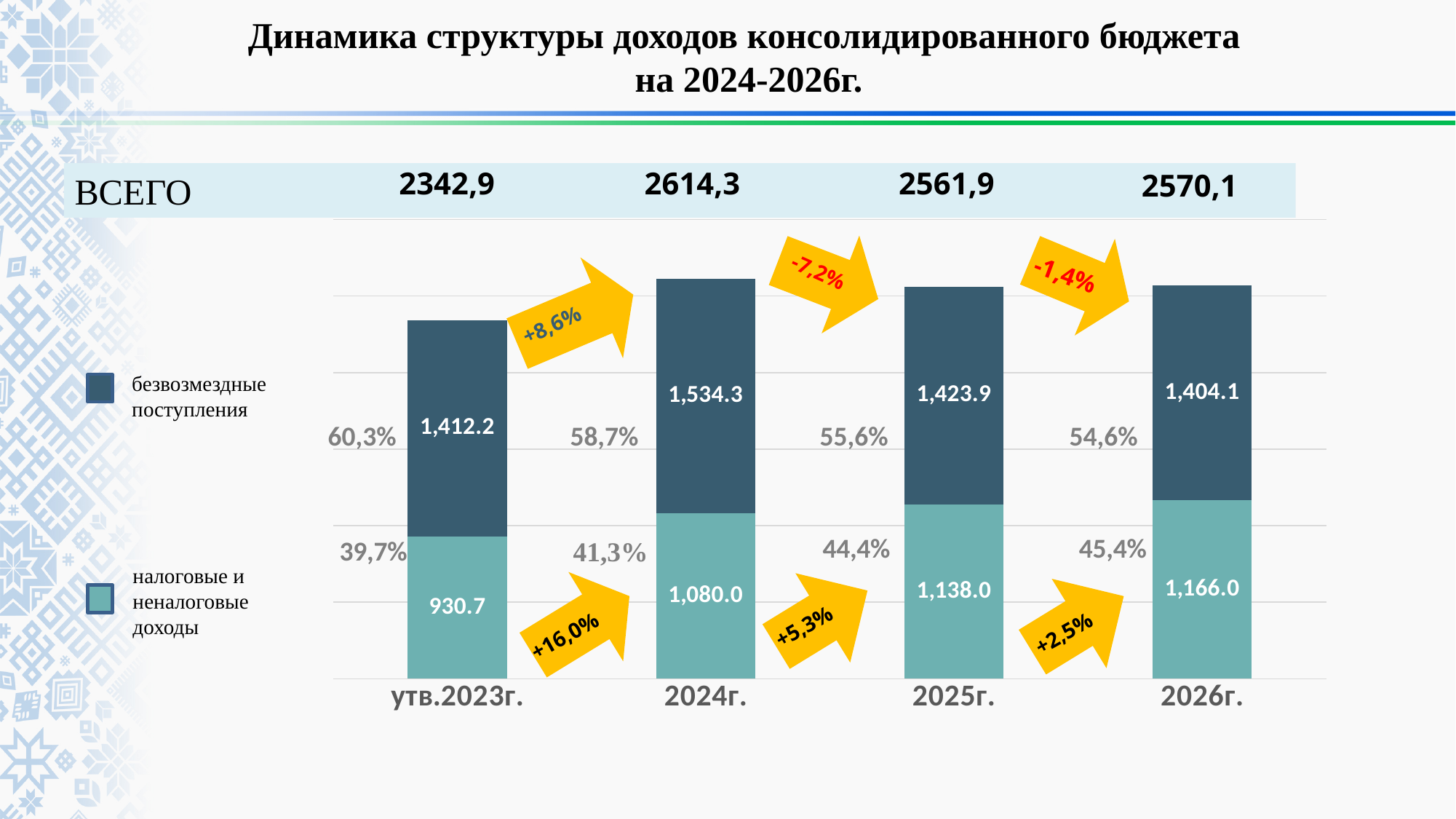
What is the total (ВСЕГО) shown for 2025г.? 2561,9 What kind of chart is shown on the slide? stacked bar chart How many years (categories) are shown on the x axis? 4 What is the value of безвозмездные поступления for утв.2023г.? 1,412.2 What is the value of безвозмездные поступления for 2026г.? 1,404.1 Which year has the highest value for налоговые и неналоговые доходы? 2026г. How many series does the legend list? 2 Which year has the lowest value for безвозмездные поступления? 2026г. What is the value of налоговые и неналоговые доходы for 2024г.? 1,080.0 What percentage share is shown for налоговые и неналоговые доходы in 2026г.? 45,4% Which is larger: безвозмездные поступления in 2024г. or in 2025г.? 2024г. What is the difference between налоговые и неналоговые доходы in 2025г. and in 2024г.? 58.0